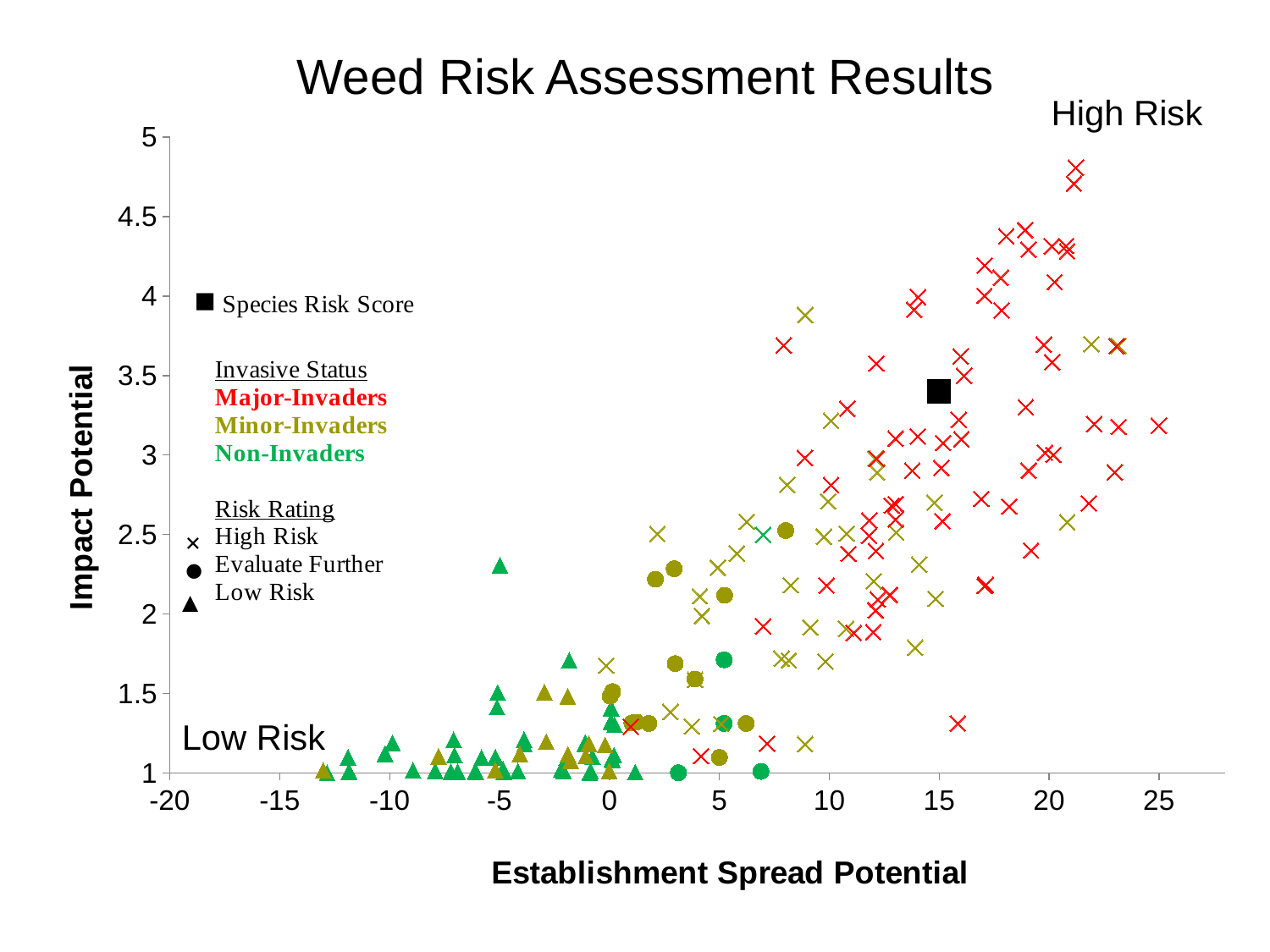
What is the highest value shown on the y axis? 5 What is the label of the x axis? Establishment Spread Potential Is the Impact Potential of the Species Risk Score (black square) greater or less than 4? less Do the Impact Potential values generally rise or fall as Establishment Spread Potential increases? rise Is the Impact Potential of the Species Risk Score (black square) greater or less than 3? greater What is the label of the y axis? Impact Potential Is the highest Impact Potential plotted on the chart greater or less than 4.5? greater Which invasive status group contains the point with the highest Impact Potential? Major-Invaders How many invasive status groups does the legend list? 3 What kind of chart is shown on the slide? scatter plot